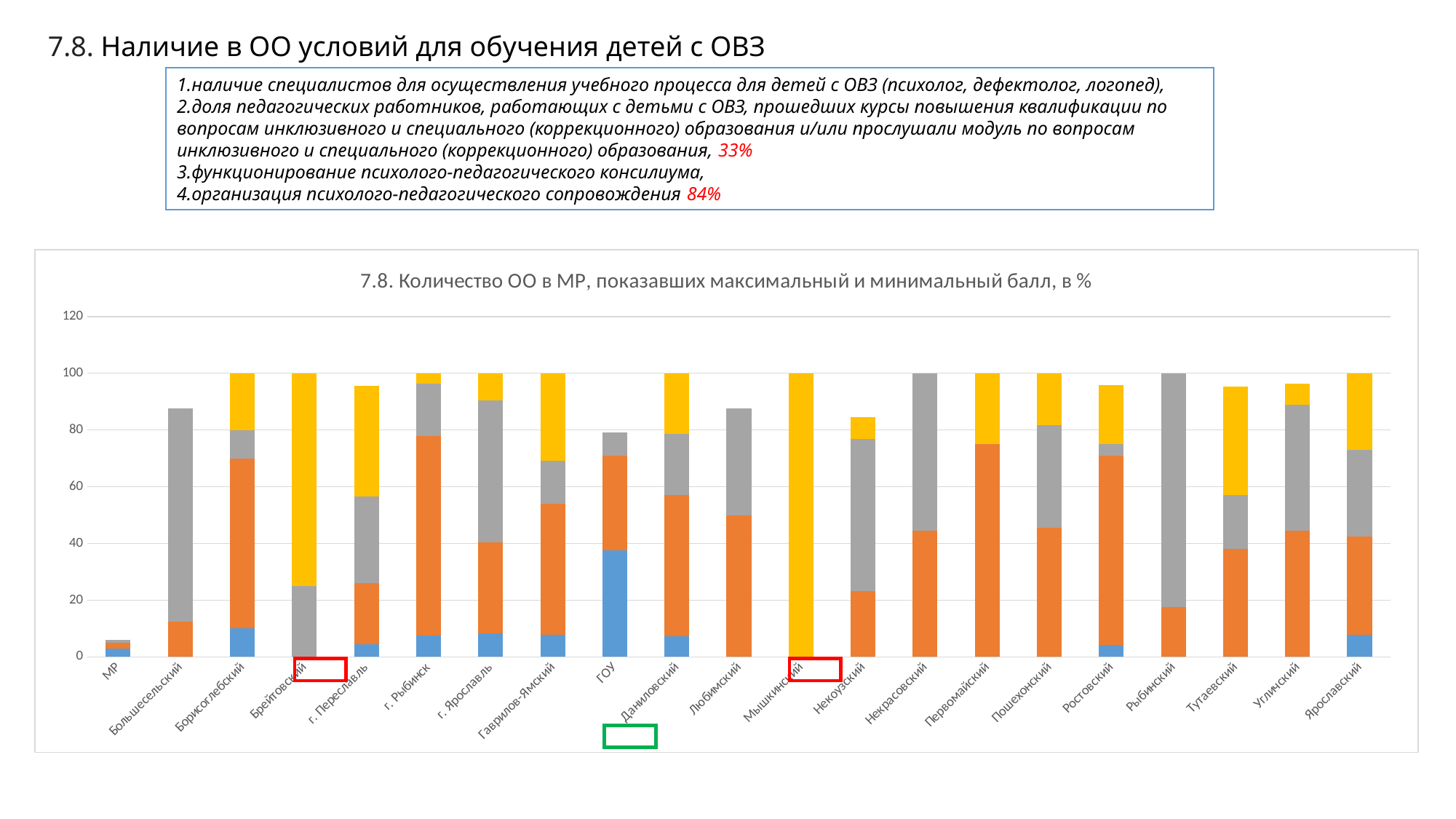
What is the title of the chart? 7.8. Количество ОО в МР, показавших максимальный и минимальный балл, в % Which is larger, the total bar height for Большесельский or for МР? Большесельский Which category's bar consists of a single yellow segment reaching 100? Мышкинский How many categories are shown along the x axis of the chart? 21 Is the total bar height for ГОУ greater or less than 100? less Which category has the lowest total bar height in the chart? МР Is the total bar height for ГОУ greater or less than 60? greater Is the total bar height for МР greater or less than 20? less What kind of chart is shown on the slide? Stacked bar chart